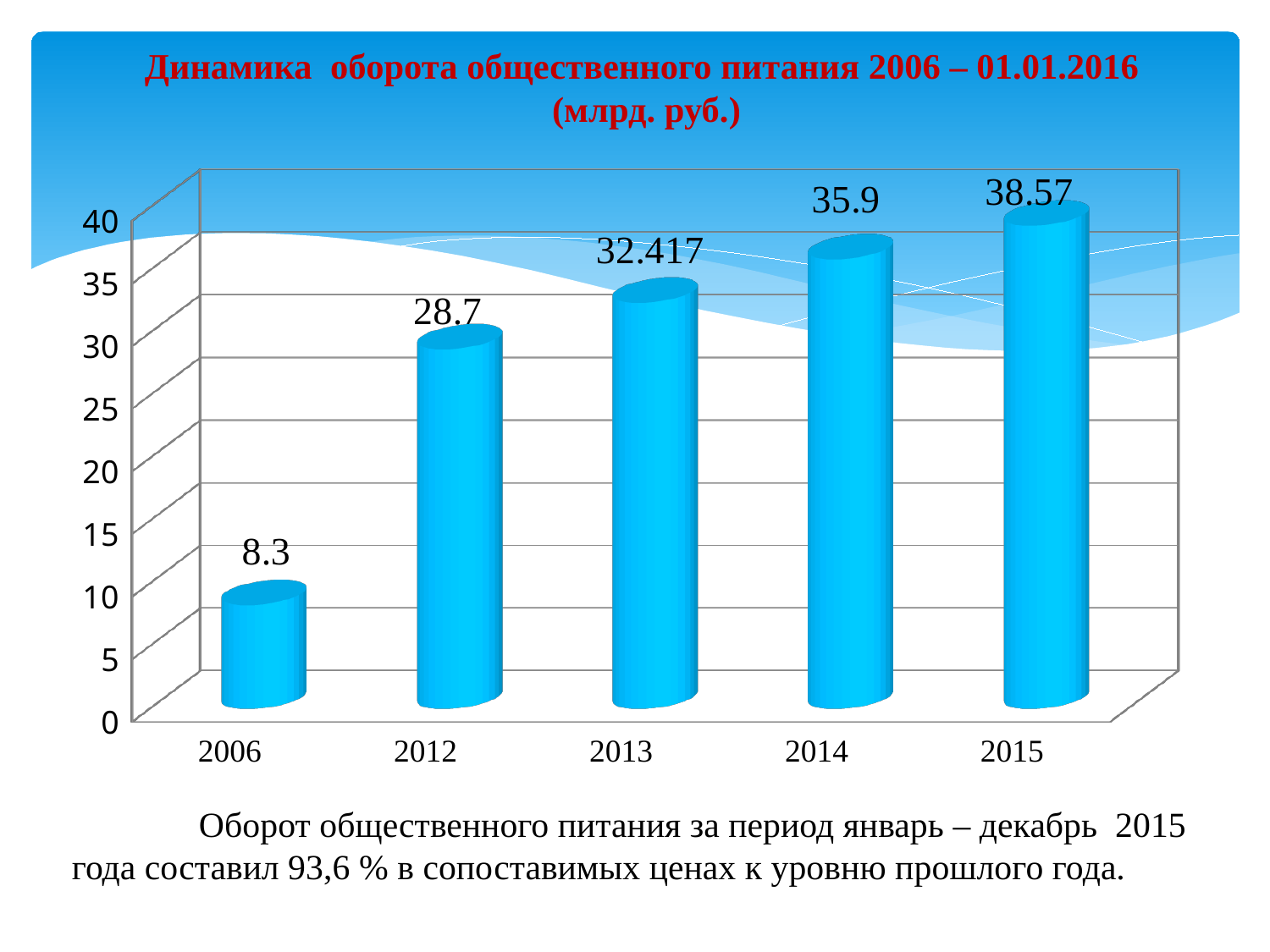
What is the value for 2006? 8.3 What is the difference between the values for 2015 and 2014? 2.67 What is the value for 2013? 32.417 What kind of chart is shown on the slide? bar chart What is the value for 2015? 38.57 What is the difference between the values for 2012 and 2006? 20.4 Is the value for 2013 greater or less than 30? greater How many years are shown on the x axis? 5 Which year has the highest value? 2015 Which year has the lowest value? 2006 Do the values rise or fall from 2006 to 2015? rise Which is larger, the value for 2012 or the value for 2014? 2014